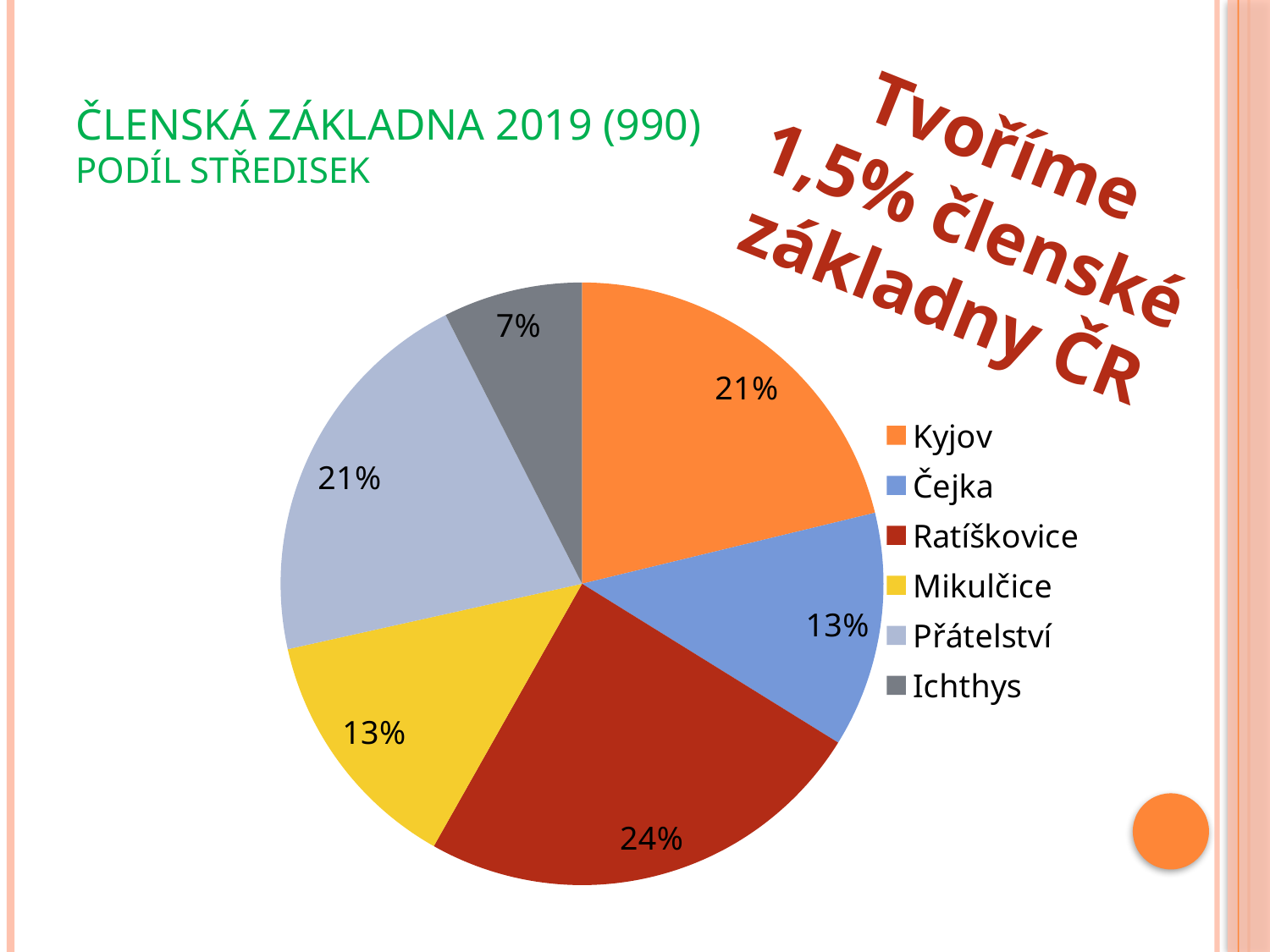
What is the difference in percentage points between Ratíškovice and Ichthys? 17 Which category has the largest slice of the pie? Ratíškovice What share of the pie does Kyjov have? 21% What share of the pie does Čejka have? 13% What share of the pie does Ichthys have? 7% Which is larger, the slice for Kyjov or the slice for Mikulčice? Kyjov Which category has the smallest slice of the pie? Ichthys What share of the pie does Ratíškovice have? 24% What kind of chart is shown on the slide? pie chart What is the combined share of Kyjov and Přátelství? 42% How many categories does the pie chart have? 6 Which colour represents Mikulčice in the pie chart? yellow